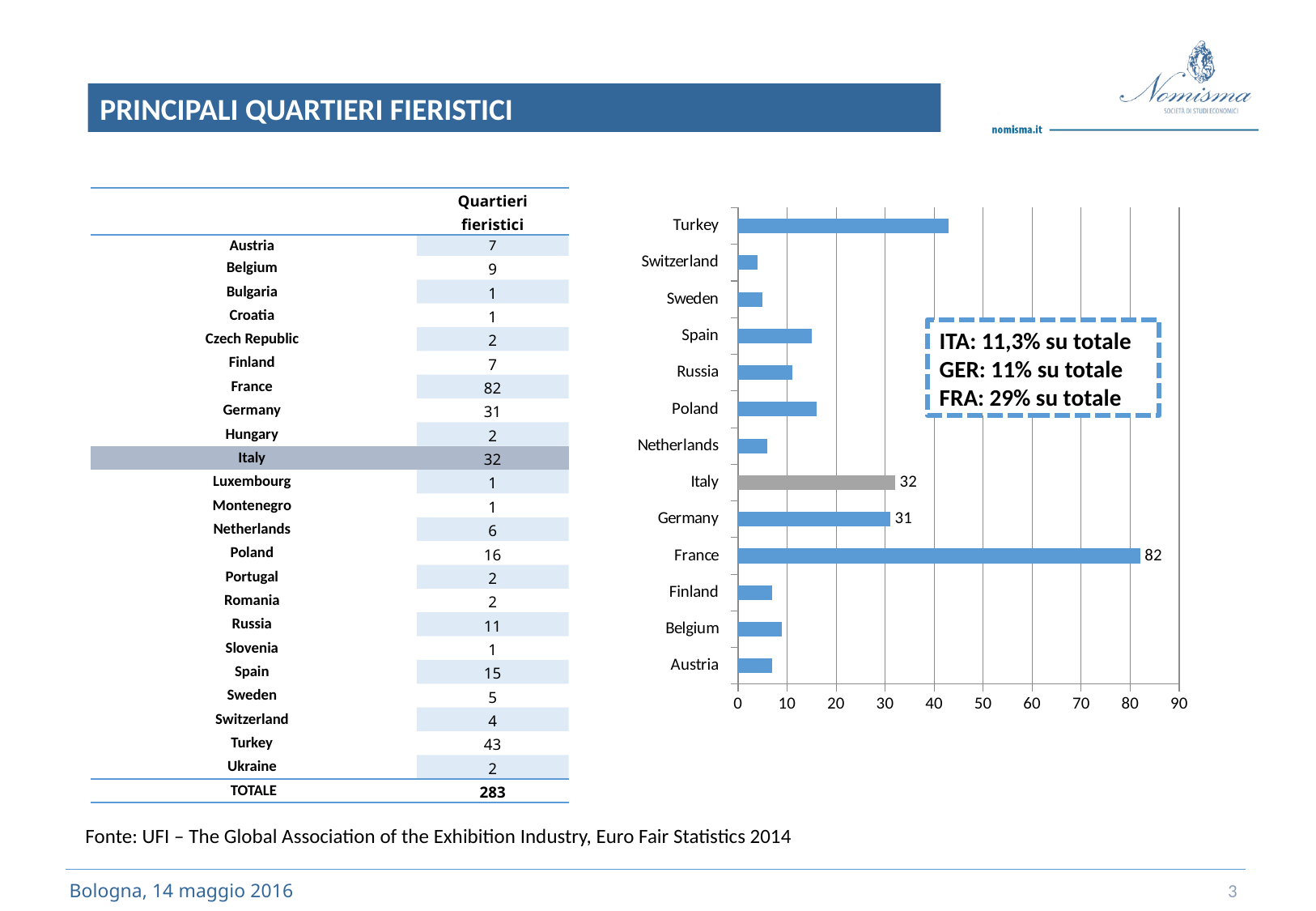
How many countries are shown in the bar chart? 13 Is the value for Turkey in the bar chart greater or less than 40? greater In the bar chart, which is larger: the value for Turkey or the value for Poland? Turkey What kind of chart is shown on the slide? bar chart What is the difference between the values for Italy and Germany in the bar chart? 1 Which country has the highest value in the bar chart? France What is the value for France in the bar chart? 82 Which country's bar is coloured grey instead of blue in the bar chart? Italy What is the value for Germany in the bar chart? 31 Is the value for Switzerland in the bar chart greater or less than 10? less What is the difference between the values for France and Italy in the bar chart? 50 What is the value for Italy in the bar chart? 32